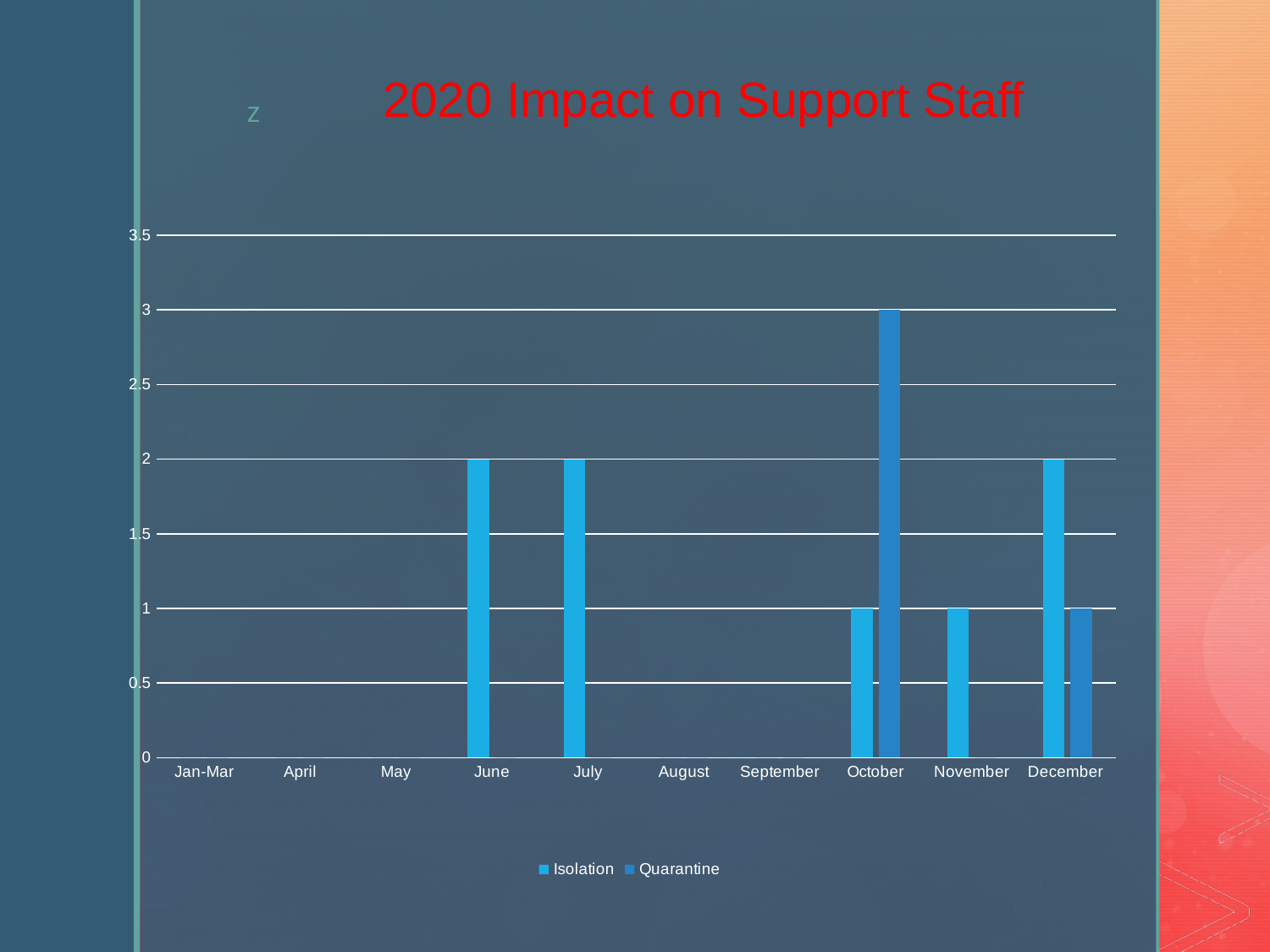
How many series does the legend list? 2 What is the Isolation value for June? 2 What is the Quarantine value for October? 3 What is the title of the chart? 2020 Impact on Support Staff What kind of chart is shown on the slide? bar chart Is the Quarantine value for October greater or less than 2.5? greater How many categories are shown on the x axis? 10 What is the Isolation value for November? 1 Which month has the highest Quarantine value? October What is the Quarantine value for December? 1 What is the difference between the Isolation value for December and the Quarantine value for December? 1 Which is larger in October, the Isolation value or the Quarantine value? Quarantine